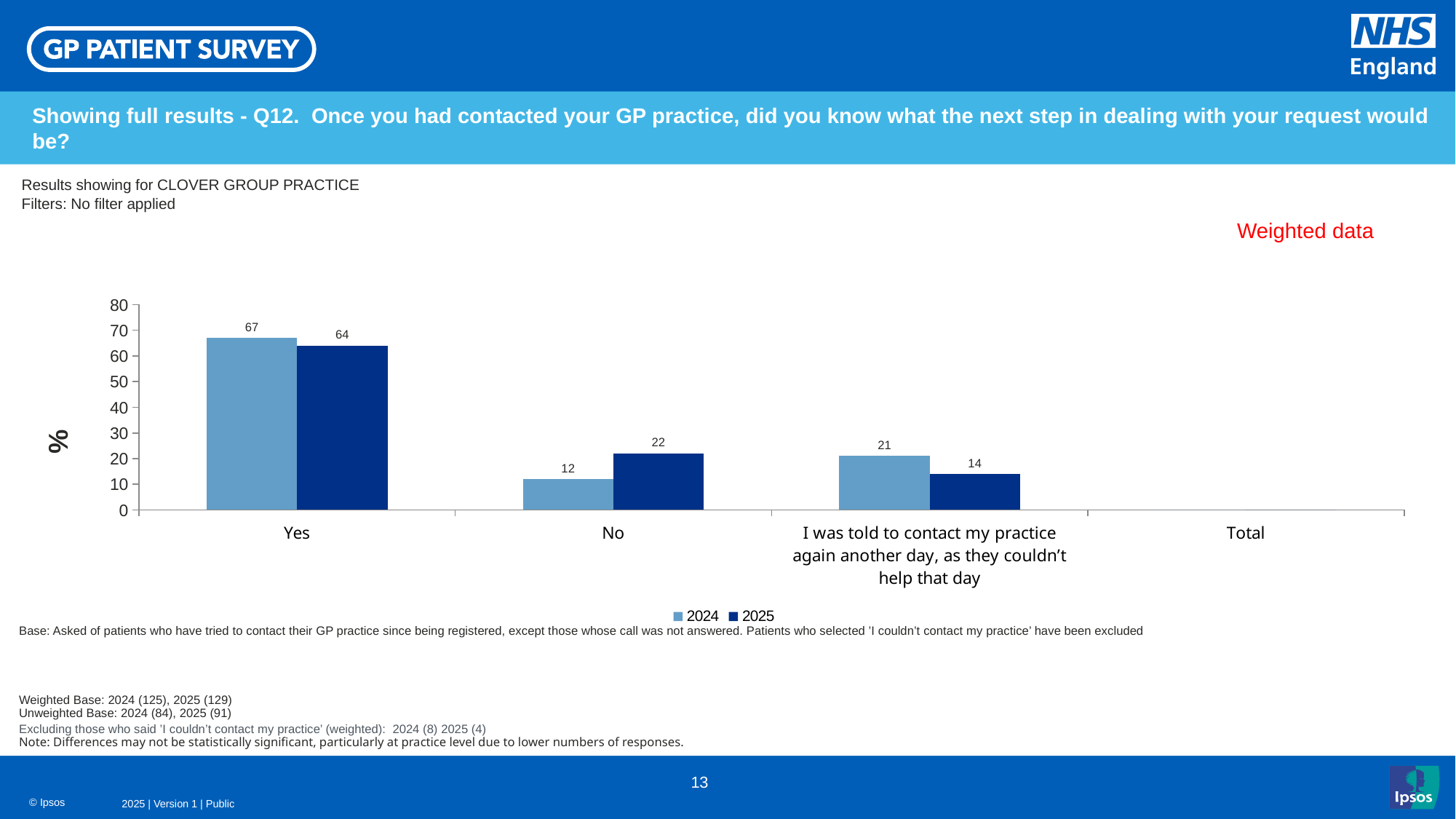
What is the difference between the 2024 and 2025 values for 'Yes'? 3 For 'No', which year has the larger value, 2024 or 2025? 2025 What kind of chart is shown on the slide? Bar chart Is the 2024 value for 'Yes' greater or less than 60? greater What is the 2025 value for 'I was told to contact my practice again another day, as they couldn't help that day'? 14 What is the 2025 value for 'No'? 22 What is the label on the vertical axis of the chart? % Which category has the lowest 2024 value? No How many series does the legend list? 2 What is the 2024 value for 'Yes'? 67 Which category has the highest 2025 value? Yes What is the difference between the 2025 and 2024 values for 'No'? 10